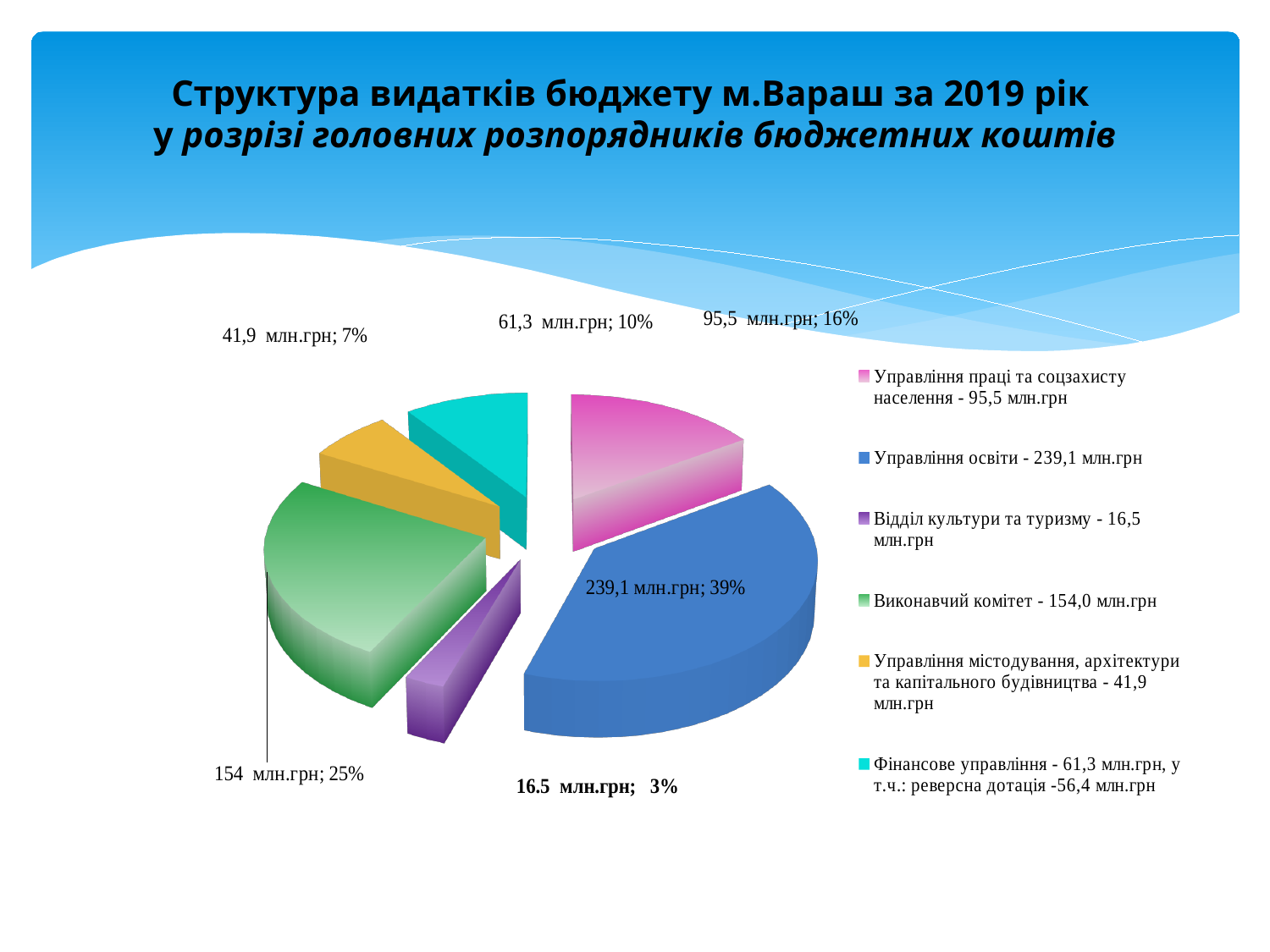
What share of the pie does Управління освіти account for? 39% What is the value shown for Відділ культури та туризму? 16.5 млн.грн What kind of chart is shown on the slide? pie chart Which category has the largest slice of the pie? Управління освіти What is the value shown for Фінансове управління? 61,3 млн.грн Which is larger, the value for Виконавчий комітет or the value for Управління праці та соцзахисту населення? Виконавчий комітет How many entries does the legend list? 6 Which category has the smallest slice of the pie? Відділ культури та туризму What is the difference in percentage share between Управління освіти and Виконавчий комітет? 14% What share of the pie does Виконавчий комітет account for? 25% What share of the pie does Управління праці та соцзахисту населення account for? 16% How many slices does the pie chart have? 6